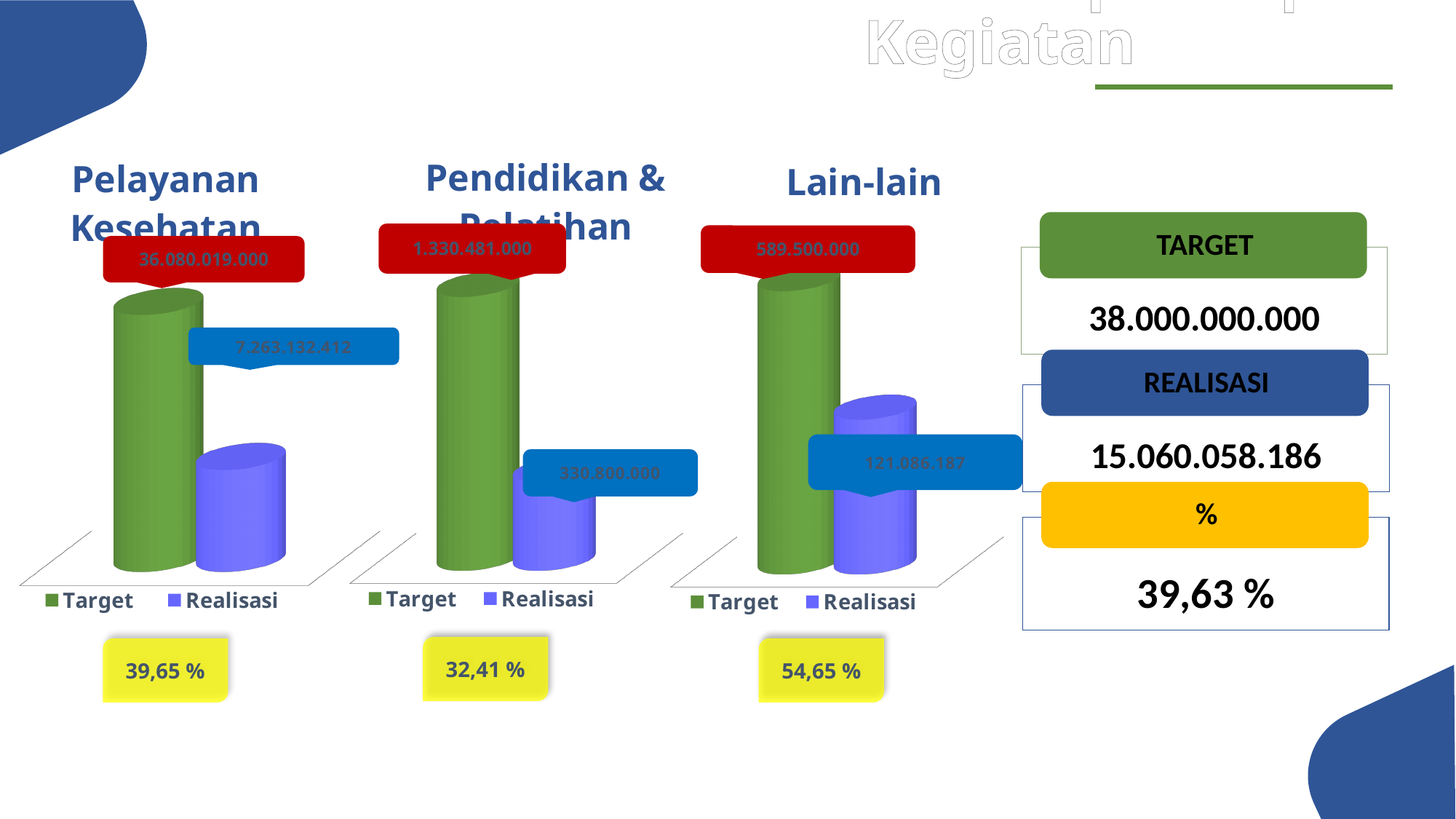
In the Pendidikan & Pelatihan chart, what is the difference between Target and Realisasi? 999.681.000 In the Pendidikan & Pelatihan chart, which is larger, Target or Realisasi? Target In the Pelayanan Kesehatan chart, what is the value of Realisasi? 7.263.132.412 In the Lain-lain chart, what is the value of Realisasi? 121.086.187 In the Pelayanan Kesehatan chart, what is the value of Target? 36.080.019.000 In the Pendidikan & Pelatihan chart, what is the value of Realisasi? 330.800.000 In the Lain-lain chart, what is the value of Target? 589.500.000 In the Pendidikan & Pelatihan chart, what is the value of Target? 1.330.481.000 What kind of chart is the Pelayanan Kesehatan chart? bar chart In the Lain-lain chart, what is the difference between Target and Realisasi? 468.413.813 In the Pelayanan Kesehatan chart, which colour represents Target in the legend? green How many series does the legend of the Lain-lain chart list? 2